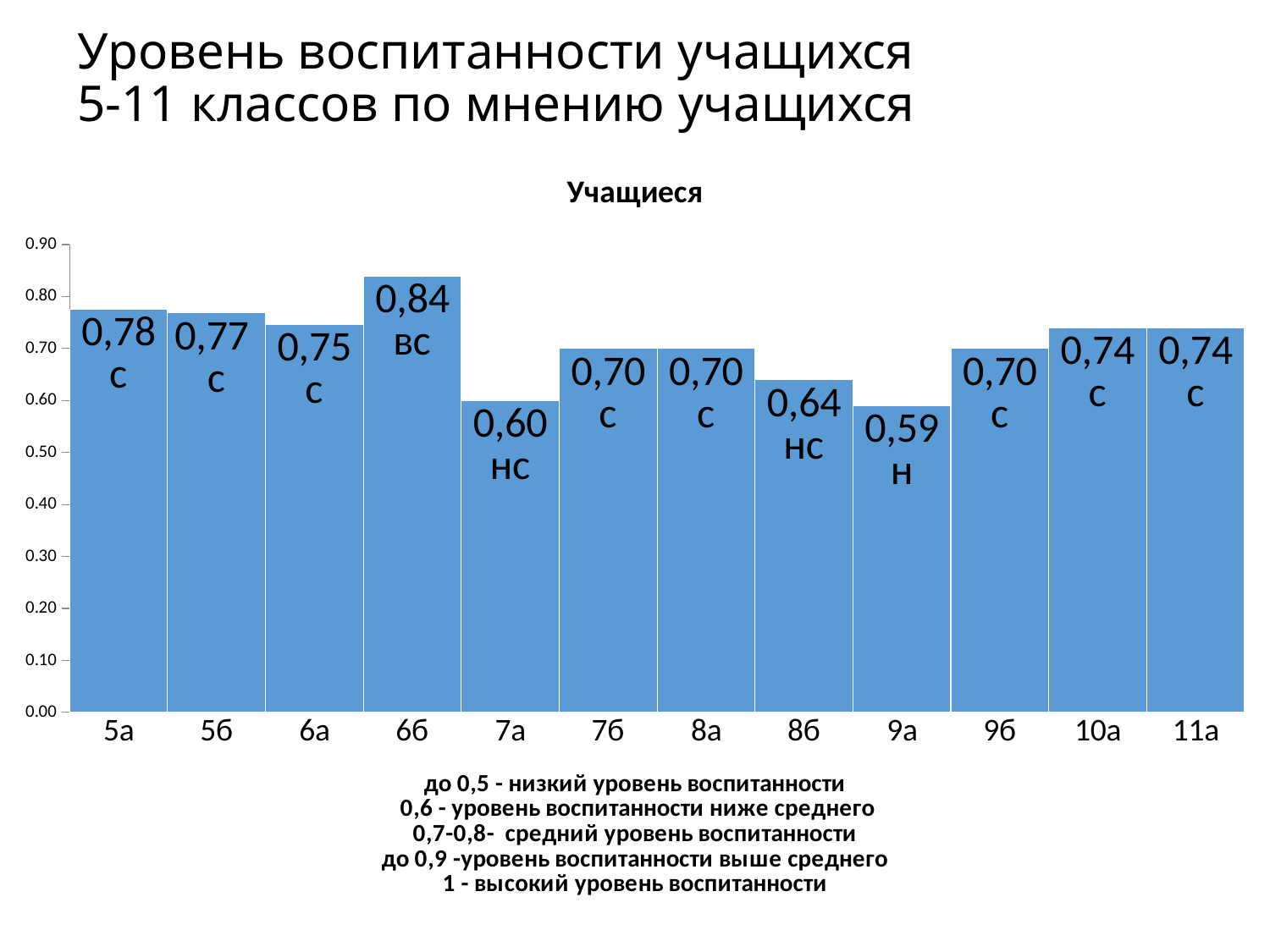
Which class has the lowest value? 9а Which is larger, the value for 5а or the value for 7а? 5а What is the value for class 9а? 0,59 What is the difference between the values for 6б and 9а? 0,25 What letter code is printed on the bar for class 6б? вс Is the value for 7а greater or less than 0.70? less How many classes (categories) are shown on the x axis? 12 What is the value for class 8б? 0,64 What is the chart's title? Учащиеся What type of chart is shown on the slide? bar chart What is the value for class 6б? 0,84 Which class has the highest value? 6б